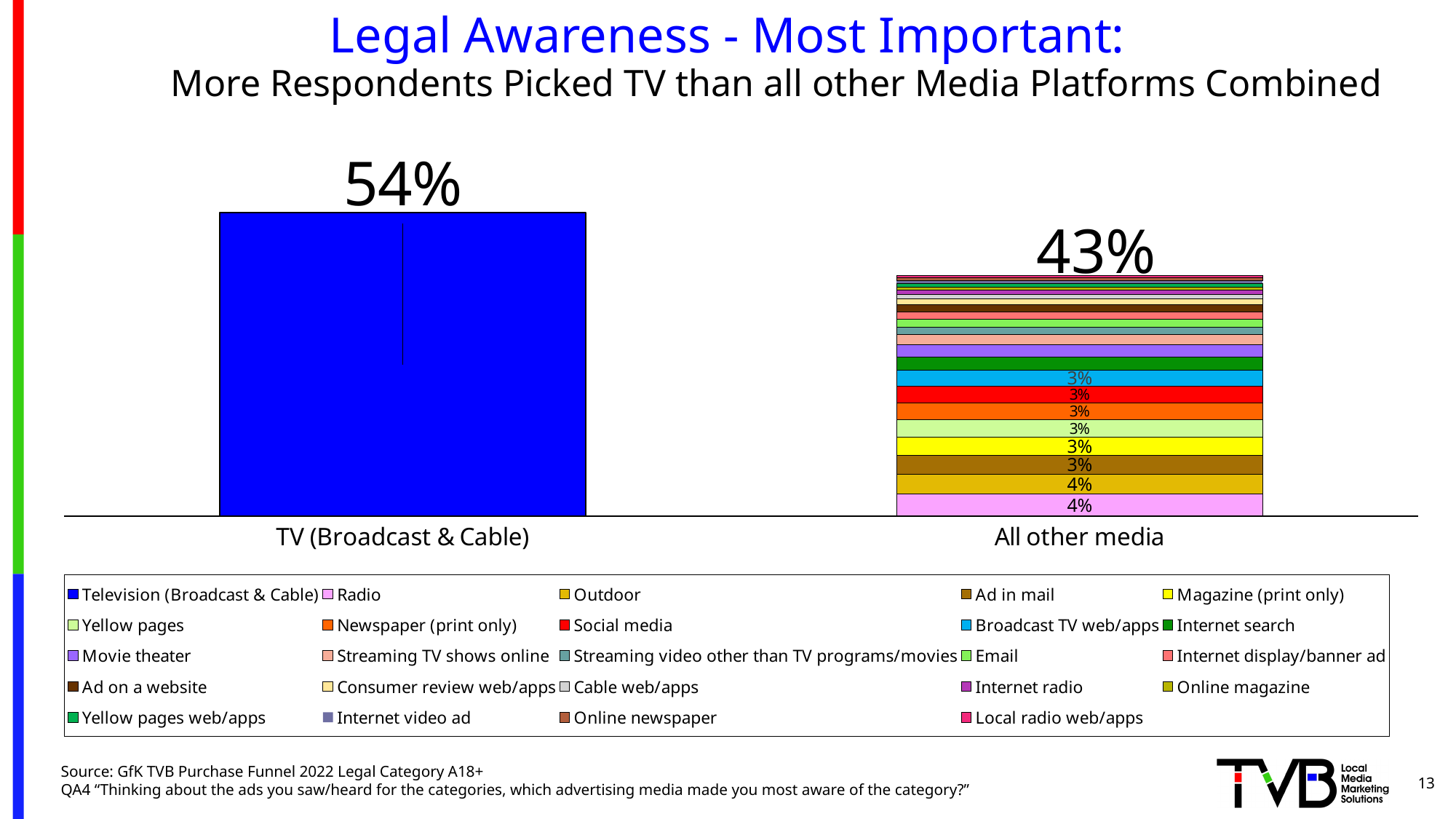
How many entries does the legend list? 24 What is the difference in percentage points between the TV (Broadcast & Cable) bar and the All other media bar? 11 percentage points Which of the two bars is taller, TV (Broadcast & Cable) or All other media? TV (Broadcast & Cable) How many categories are shown on the x axis? 2 What is the value of the Radio segment in the All other media bar? 4% What is the total value shown above the All other media bar? 43% What kind of chart is shown on the slide? Stacked bar chart What colour is the TV (Broadcast & Cable) bar? Blue What is the value of the Social media segment in the All other media bar? 3% What is the value of the Outdoor segment in the All other media bar? 4% Is the value for TV (Broadcast & Cable) greater or less than 50%? greater What is the value shown for TV (Broadcast & Cable)? 54%